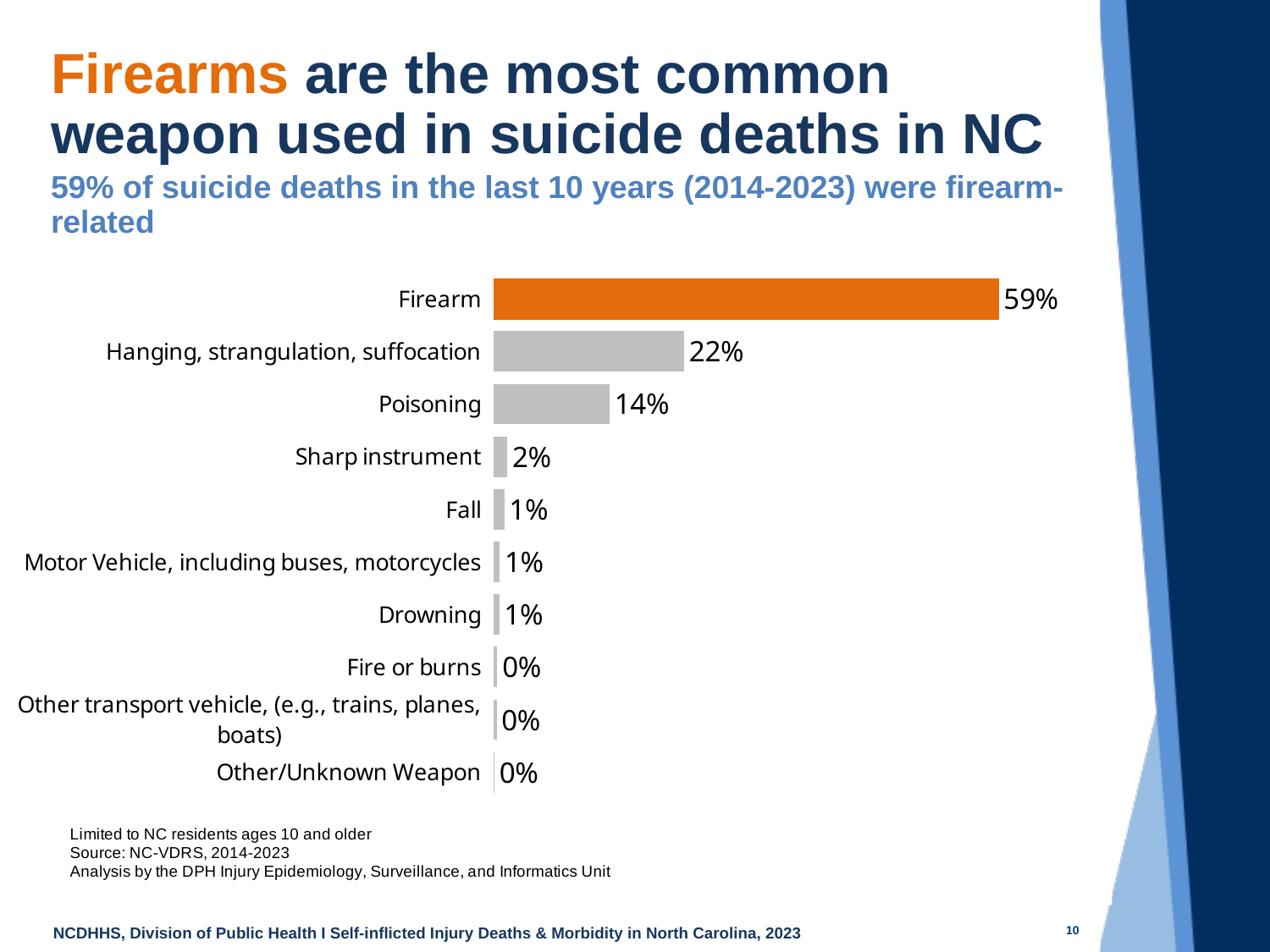
Which is larger, the value for Poisoning or the value for Sharp instrument? Poisoning What is the value for Poisoning? 14% Which bar is shown in orange rather than grey? Firearm What is the value for Hanging, strangulation, suffocation? 22% What is the value for Fire or burns? 0% What kind of chart is shown on the slide? Bar chart What is the difference in percentage points between Firearm and Hanging, strangulation, suffocation? 37 Which weapon category has the highest percentage? Firearm What is the value for Sharp instrument? 2% What percentage of suicide deaths involved a firearm? 59% How many weapon categories are shown in the chart? 10 What is the difference in percentage points between Hanging, strangulation, suffocation and Poisoning? 8